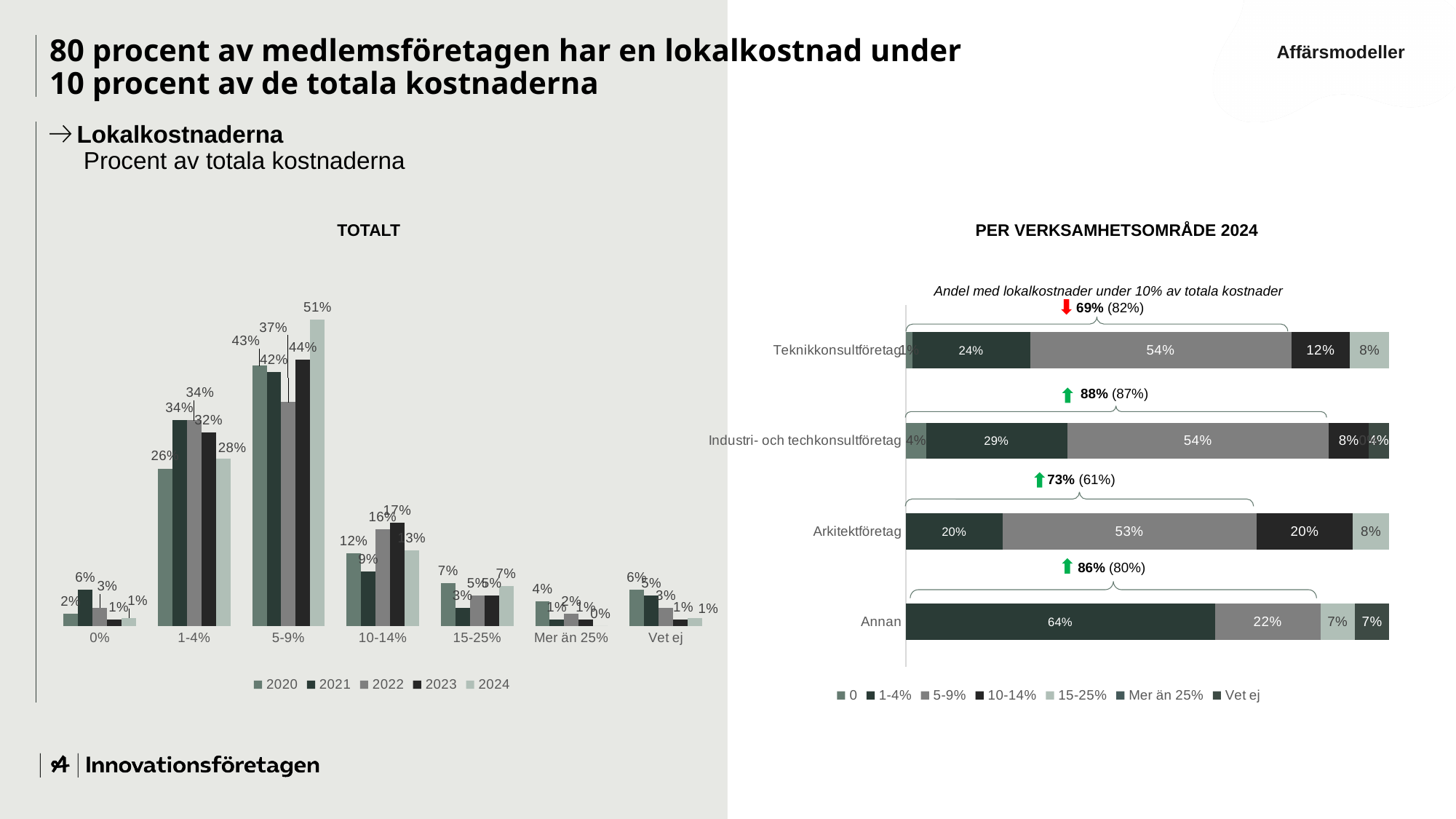
In the TOTALT chart, which category has the highest 2024 value? 5-9% How many series does the legend of the TOTALT chart list? 5 In the TOTALT chart, what is the 2020 value for the 1-4% category? 26% In the TOTALT chart, for the 10-14% category, which is larger: the 2021 value or the 2023 value? 2023 In the PER VERKSAMHETSOMRÅDE 2024 chart, what is the 1-4% value for Annan? 64% How many categories are shown on the x axis of the TOTALT chart? 7 In the TOTALT chart, what is the 2024 value for the 5-9% category? 51% In the PER VERKSAMHETSOMRÅDE 2024 chart, what share of Industri- och techkonsultföretag have local costs under 10% of total costs, according to the annotation? 88% In the PER VERKSAMHETSOMRÅDE 2024 chart, what is the 5-9% value for Arkitektföretag? 53% In the PER VERKSAMHETSOMRÅDE 2024 chart, what is the 10-14% value for Teknikkonsultföretag? 12% What kind of chart is the PER VERKSAMHETSOMRÅDE 2024 chart? Stacked horizontal bar chart In the TOTALT chart, what is the difference between the 2024 and 2020 values for the 5-9% category? 8 percentage points